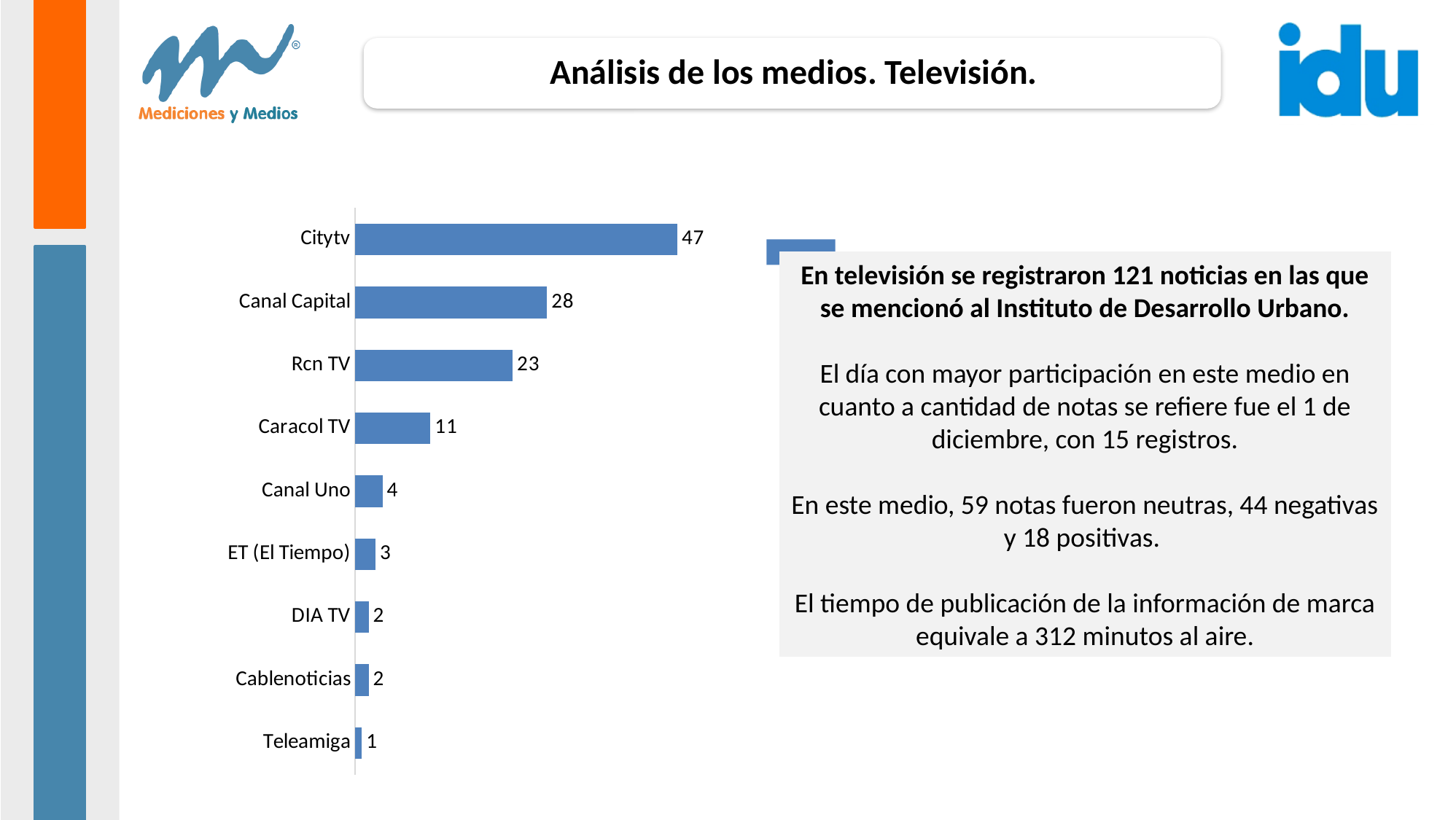
What is the difference between the values for Citytv and Canal Capital? 19 Which channel has the highest value? Citytv What kind of chart is shown on the slide? Bar chart What is the value for Caracol TV? 11 What is the difference between the values for Rcn TV and Caracol TV? 12 How many channels are shown in the chart? 9 Which channel has the lowest value? Teleamiga What is the value for Canal Capital? 28 What is the value for Citytv? 47 Which has a larger value, Canal Capital or Rcn TV? Canal Capital What colour are the bars in the chart? Blue What is the value for ET (El Tiempo)? 3